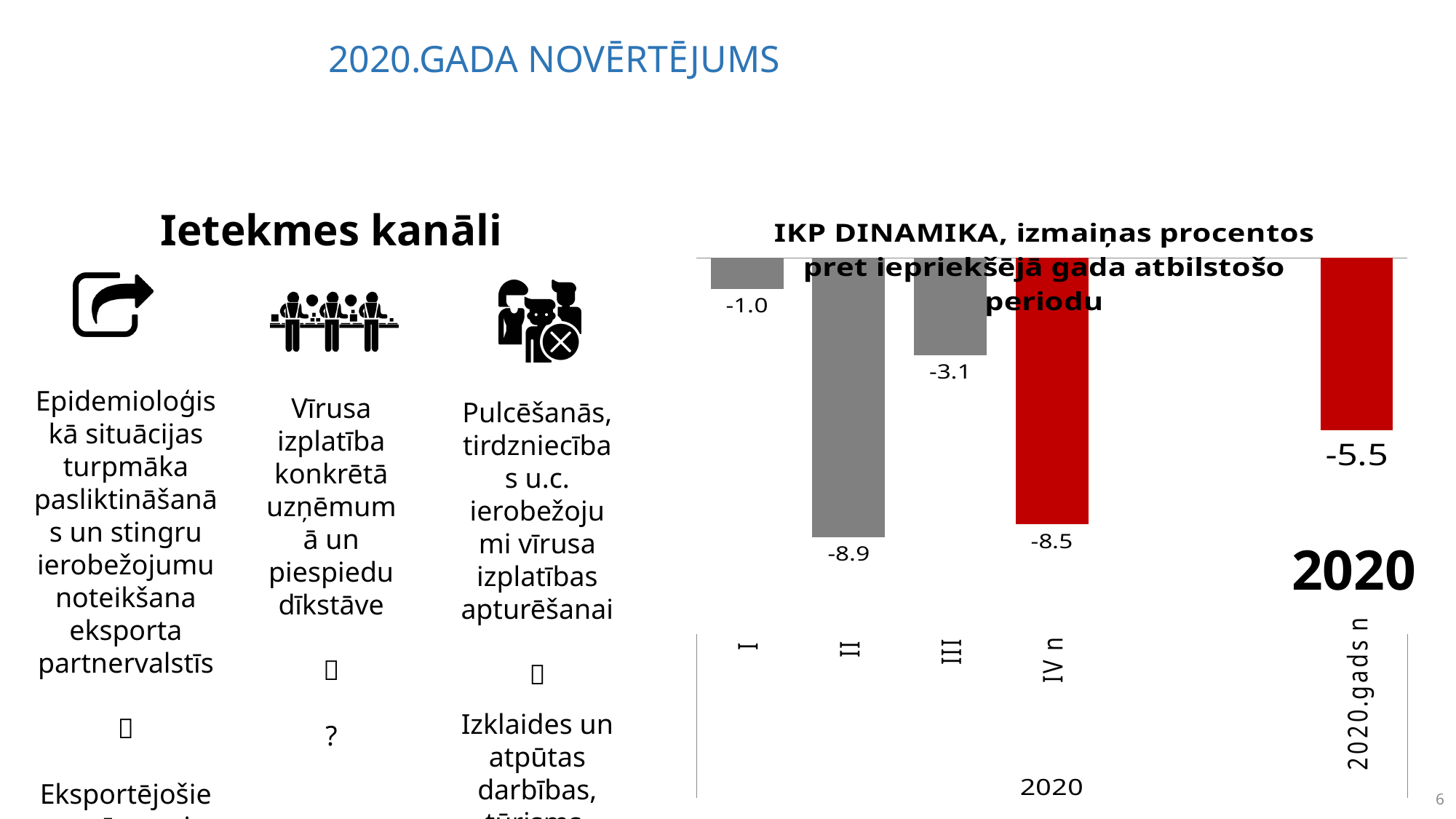
Which category has the lowest value in the IKP DINAMIKA chart? II What kind of chart is the IKP DINAMIKA chart? Bar chart What is the difference between the values for quarter I and quarter III in the IKP DINAMIKA chart? 2.1 Which category has the highest value in the IKP DINAMIKA chart? I What colour are the bars for 'IV n' and '2020.gads n' in the IKP DINAMIKA chart? Red What is the value for quarter II in the IKP DINAMIKA chart? -8.9 How many bars are plotted in the IKP DINAMIKA chart? 5 Which is larger in the IKP DINAMIKA chart, the value for quarter III or the value for 'IV n'? III What is the value for quarter I in the IKP DINAMIKA chart? -1.0 What is the value for '2020.gads n' in the IKP DINAMIKA chart? -5.5 What is the value for quarter III in the IKP DINAMIKA chart? -3.1 What is the value for 'IV n' in the IKP DINAMIKA chart? -8.5